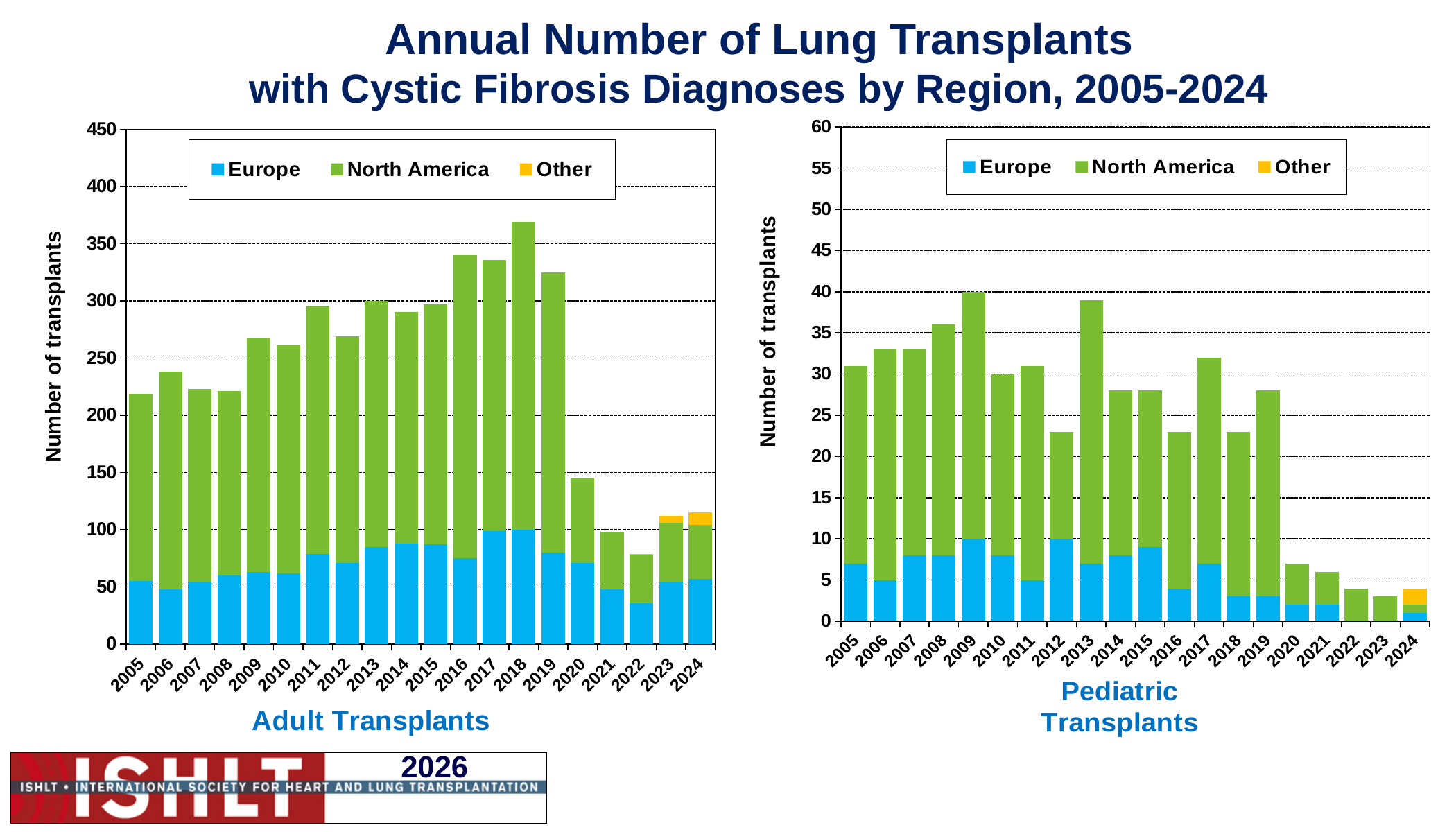
In the Adult Transplants chart, is the total for 2022 greater or less than 100? less In the Pediatric Transplants chart, is the total for 2020 greater or less than 10? less What type of chart is the Adult Transplants chart? bar chart How many years are shown on the x axis of the Adult Transplants chart? 20 How many series does the legend of the Pediatric Transplants chart list? 3 In the Adult Transplants chart, do the total values rise or fall from 2018 to 2022? fall Which colour represents North America in the legend of the Adult Transplants chart? green In the Adult Transplants chart, which year has the highest total number of transplants? 2018 In the Adult Transplants chart, is the total for 2018 greater or less than 350? greater In the Pediatric Transplants chart, which year has the highest total number of transplants? 2009 In the Adult Transplants chart, which year has the lowest total number of transplants? 2022 In the Adult Transplants chart, which year has a larger total: 2016 or 2020? 2016